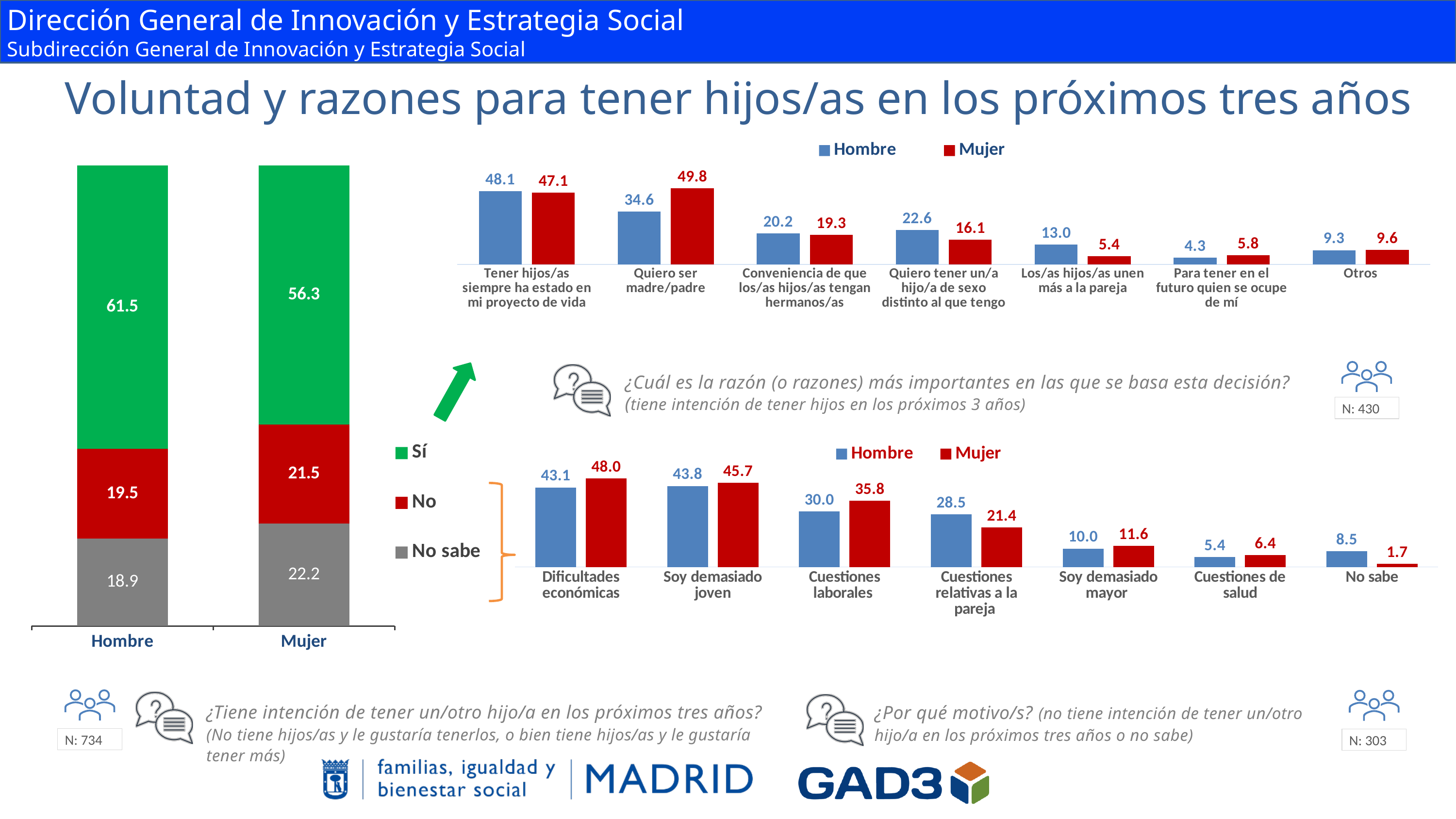
In the top-right bar chart, which is larger for 'Los/as hijos/as unen más a la pareja', Hombre or Mujer? Hombre In the bottom-right bar chart, what is the difference between the Mujer and Hombre values for 'Cuestiones relativas a la pareja'? 7.1 In the stacked bar chart on the left, how many series does the legend list? 3 In the stacked bar chart on the left, what is the difference between the 'Sí' values for Hombre and Mujer? 5.2 In the top-right bar chart, which category has the lowest Hombre value? Para tener en el futuro quien se ocupe de mí In the stacked bar chart on the left, what is the 'Sí' value for Hombre? 61.5 In the bottom-right bar chart, which category has the highest Mujer value? Dificultades económicas What kind of chart is the bottom-right chart? Bar chart In the top-right bar chart, what is the Mujer value for 'Quiero ser madre/padre'? 49.8 In the top-right bar chart, how many categories are shown on the x axis? 7 In the stacked bar chart on the left, what is the 'No sabe' value for Mujer? 22.2 In the bottom-right bar chart, what is the Hombre value for 'Cuestiones laborales'? 30.0